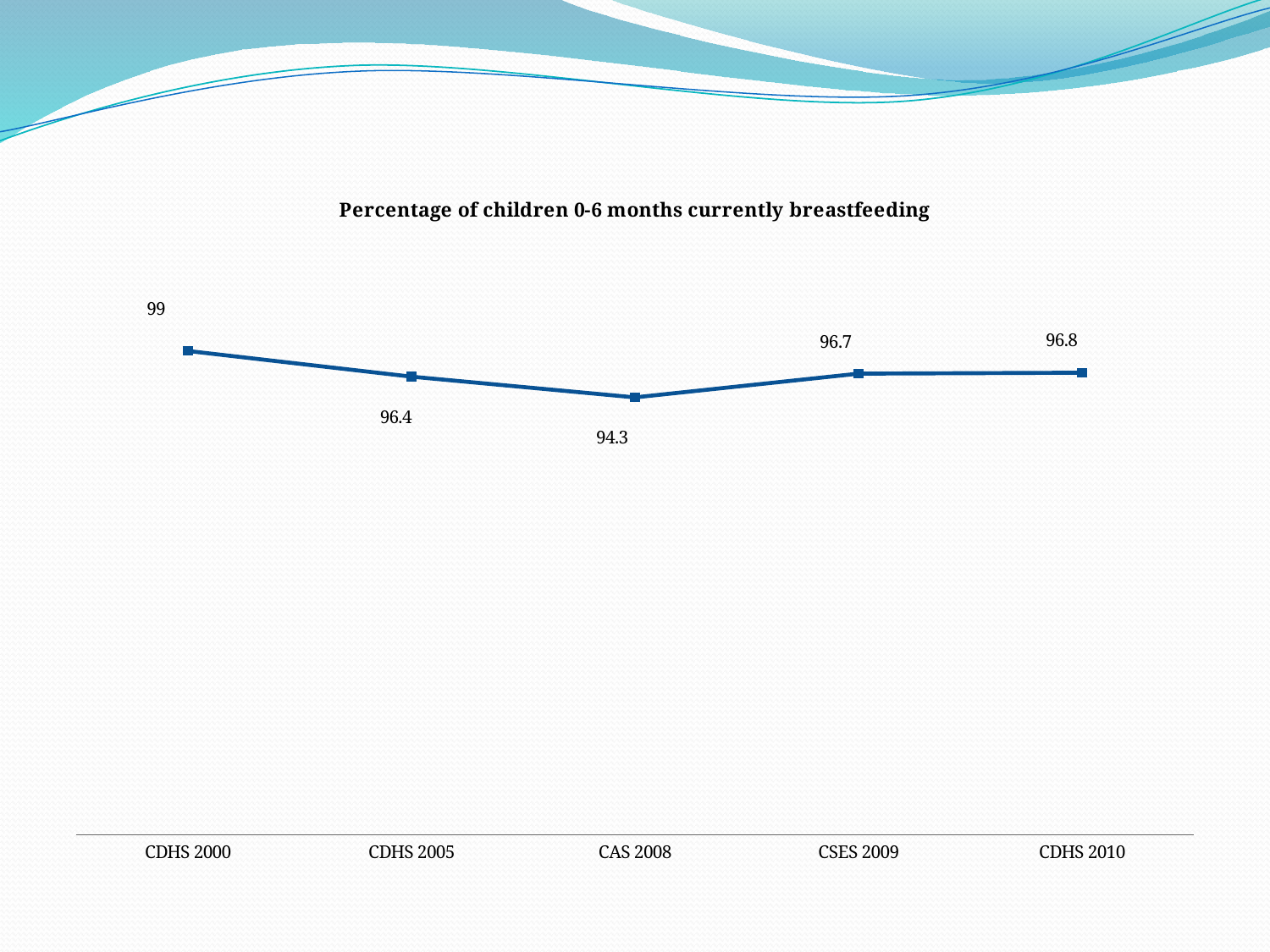
What is the difference between the values for CDHS 2005 and CAS 2008? 2.1 What kind of chart is shown on the slide? Line chart What is the value for CDHS 2010? 96.8 What is the value for CDHS 2000? 99 Which is larger, the value for CDHS 2005 or the value for CAS 2008? CDHS 2005 Which survey has the highest percentage of children 0-6 months currently breastfeeding? CDHS 2000 What is the value for CSES 2009? 96.7 How many surveys are plotted on the chart? 5 What is the value for CAS 2008? 94.3 What is the title of the chart? Percentage of children 0-6 months currently breastfeeding What is the difference between the values for CDHS 2000 and CAS 2008? 4.7 Which survey has the lowest percentage of children 0-6 months currently breastfeeding? CAS 2008